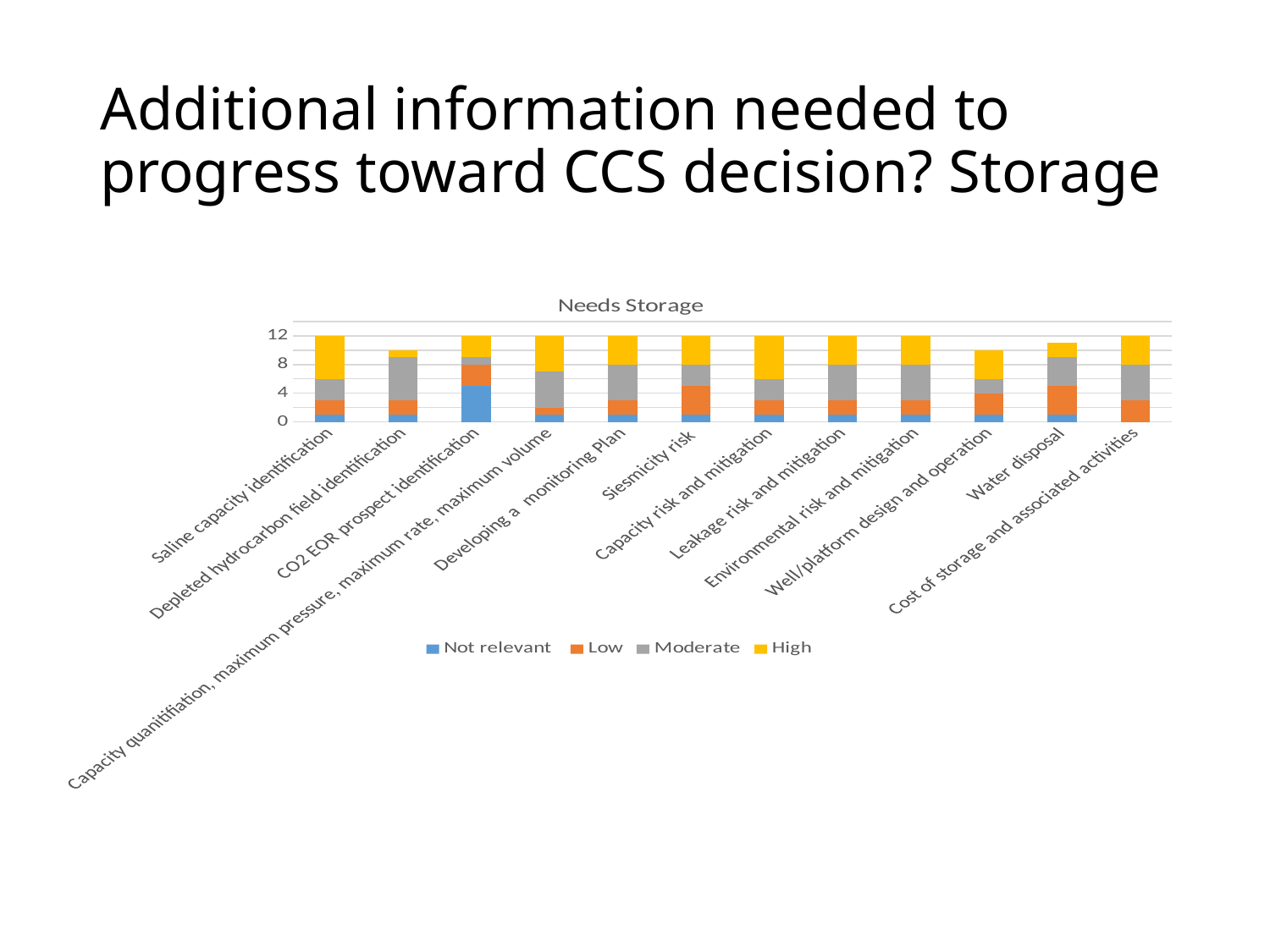
What are the series names listed in the legend? Not relevant, Low, Moderate, High How many categories are shown along the x axis of the chart? 12 Is the Not relevant value for CO2 EOR prospect identification greater or less than 4? greater What is the title of the chart? Needs Storage Is the total for Well/platform design and operation greater or less than 12? less Which has the larger total, Saline capacity identification or Depleted hydrocarbon field identification? Saline capacity identification Is the total for Water disposal greater or less than 8? greater Which has the larger High segment, Saline capacity identification or Depleted hydrocarbon field identification? Saline capacity identification What is the total height of the stacked bar for Saline capacity identification? 12 What kind of chart is shown on the slide? Stacked bar chart How many series does the legend list? 4